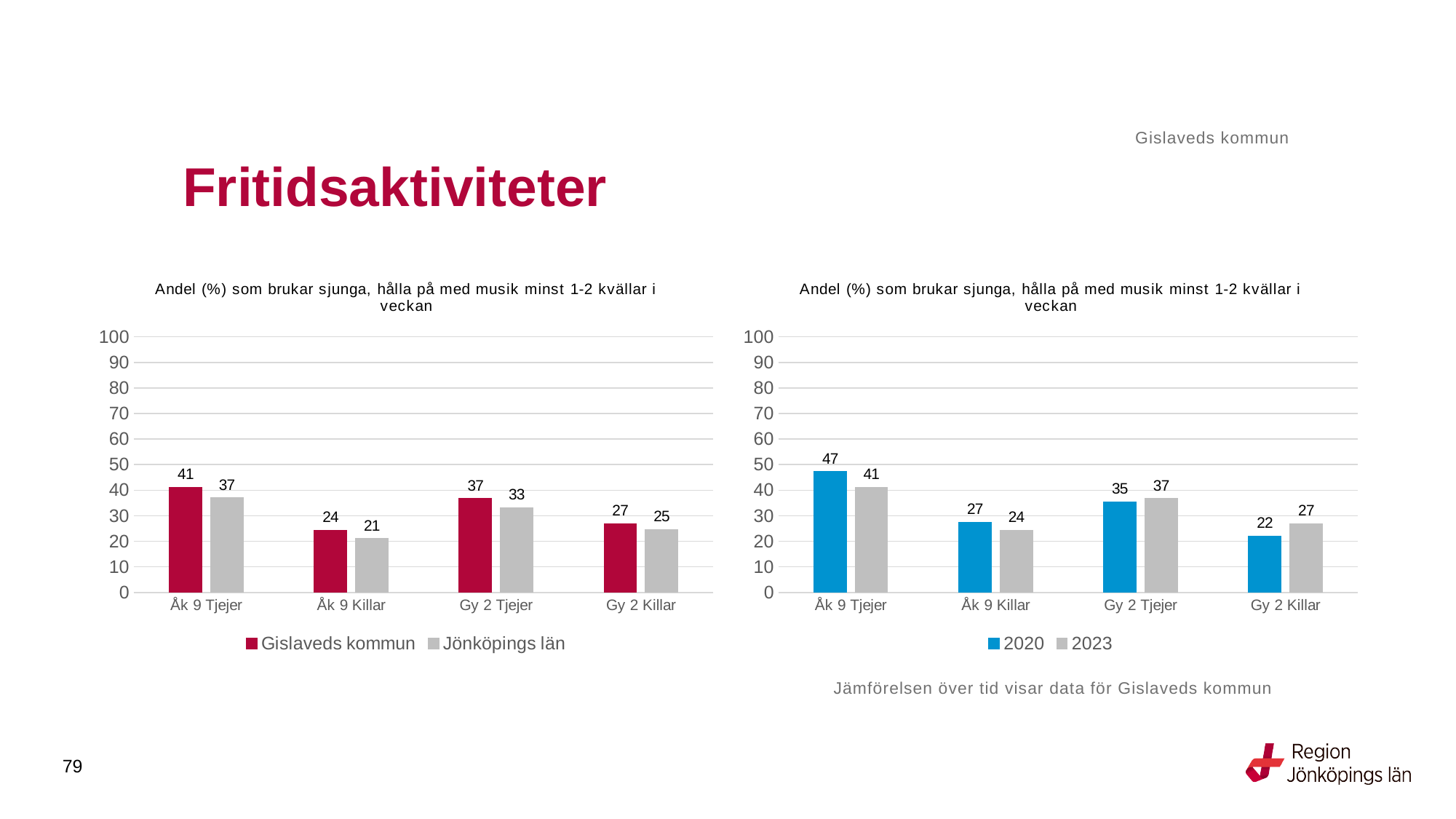
In the right chart, what is the value for 2020 for Åk 9 Tjejer? 47 How many categories are shown on the x axis of the left chart? 4 How many series does the legend of the right chart list? 2 In the left chart, which category has the lowest value for Jönköpings län? Åk 9 Killar In the left chart, what is the value for Gislaveds kommun for Åk 9 Tjejer? 41 What kind of chart is the left chart? Bar chart In the left chart, what is the value for Jönköpings län for Gy 2 Killar? 25 In the right chart, what is the difference between 2020 and 2023 for Åk 9 Tjejer? 6 In the right chart, what is the value for 2023 for Gy 2 Killar? 27 In the right chart, which category has the highest value for 2020? Åk 9 Tjejer In the right chart, which is larger for Gy 2 Killar: 2020 or 2023? 2023 In the left chart, what is the difference between Gislaveds kommun and Jönköpings län for Gy 2 Tjejer? 4